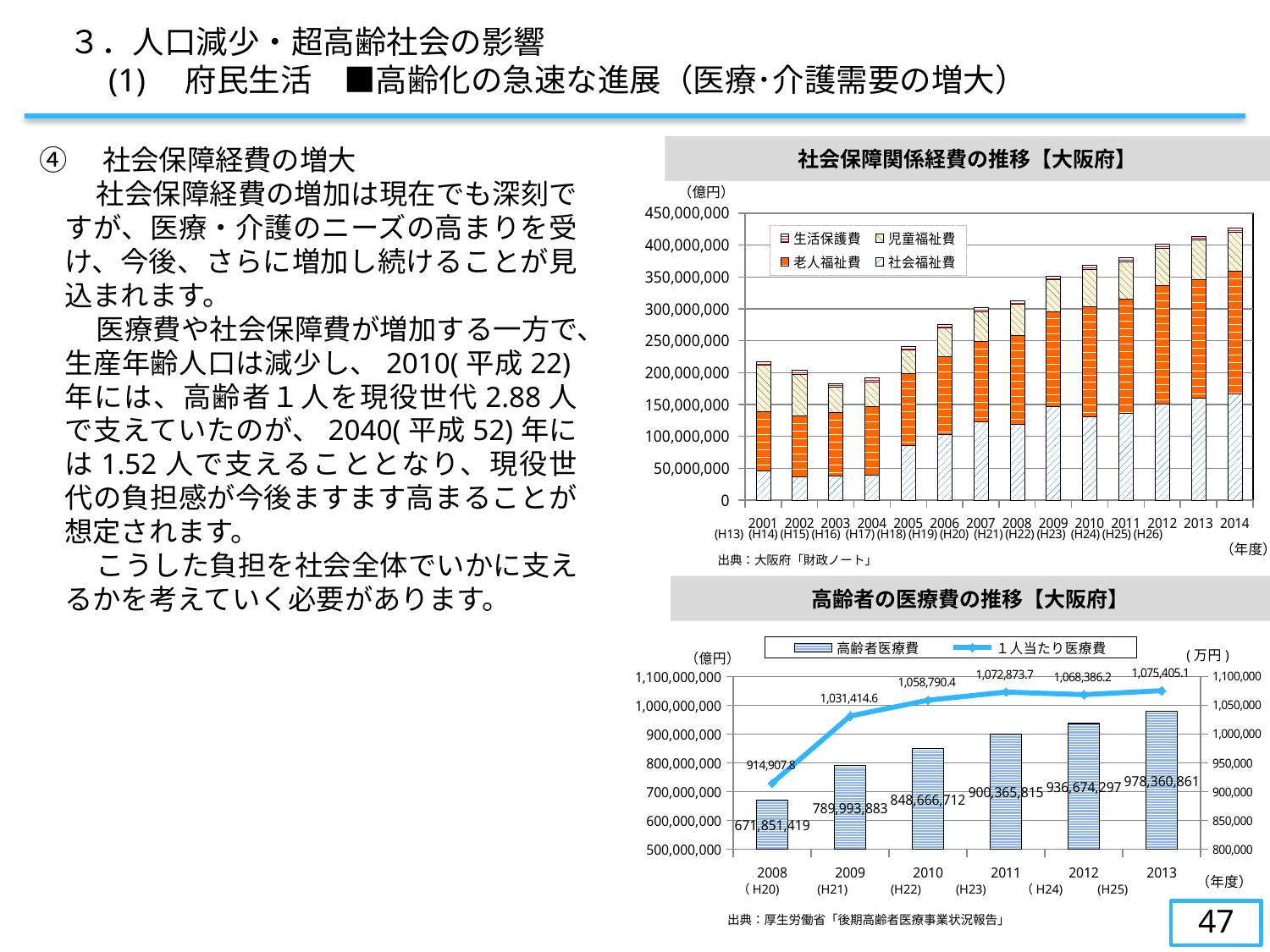
In the 高齢者の医療費の推移【大阪府】 chart, does 高齢者医療費 rise or fall from 2008 to 2013? rise In the 社会保障関係経費の推移【大阪府】 chart, is the total for 2014 greater or less than 400,000,000? greater In the 高齢者の医療費の推移【大阪府】 chart, which is larger, the 1人当たり医療費 for 2011 or for 2012? 2011 How many fiscal years are plotted in the 社会保障関係経費の推移【大阪府】 chart? 14 In the 社会保障関係経費の推移【大阪府】 chart, which year has the highest total? 2014 In the 社会保障関係経費の推移【大阪府】 chart, is the total for 2003 greater or less than 200,000,000? less In the 高齢者の医療費の推移【大阪府】 chart, what is the value of 高齢者医療費 for 2008? 671,851,419 How many series does the legend of the 社会保障関係経費の推移【大阪府】 chart list? 4 In the 高齢者の医療費の推移【大阪府】 chart, what is the difference in 高齢者医療費 between 2013 and 2008? 306,509,442 In the 高齢者の医療費の推移【大阪府】 chart, what is the value of 1人当たり医療費 for 2011? 1,072,873.7 What kind of chart is the 社会保障関係経費の推移【大阪府】 chart? stacked bar chart In the 高齢者の医療費の推移【大阪府】 chart, which year has the highest 高齢者医療費? 2013